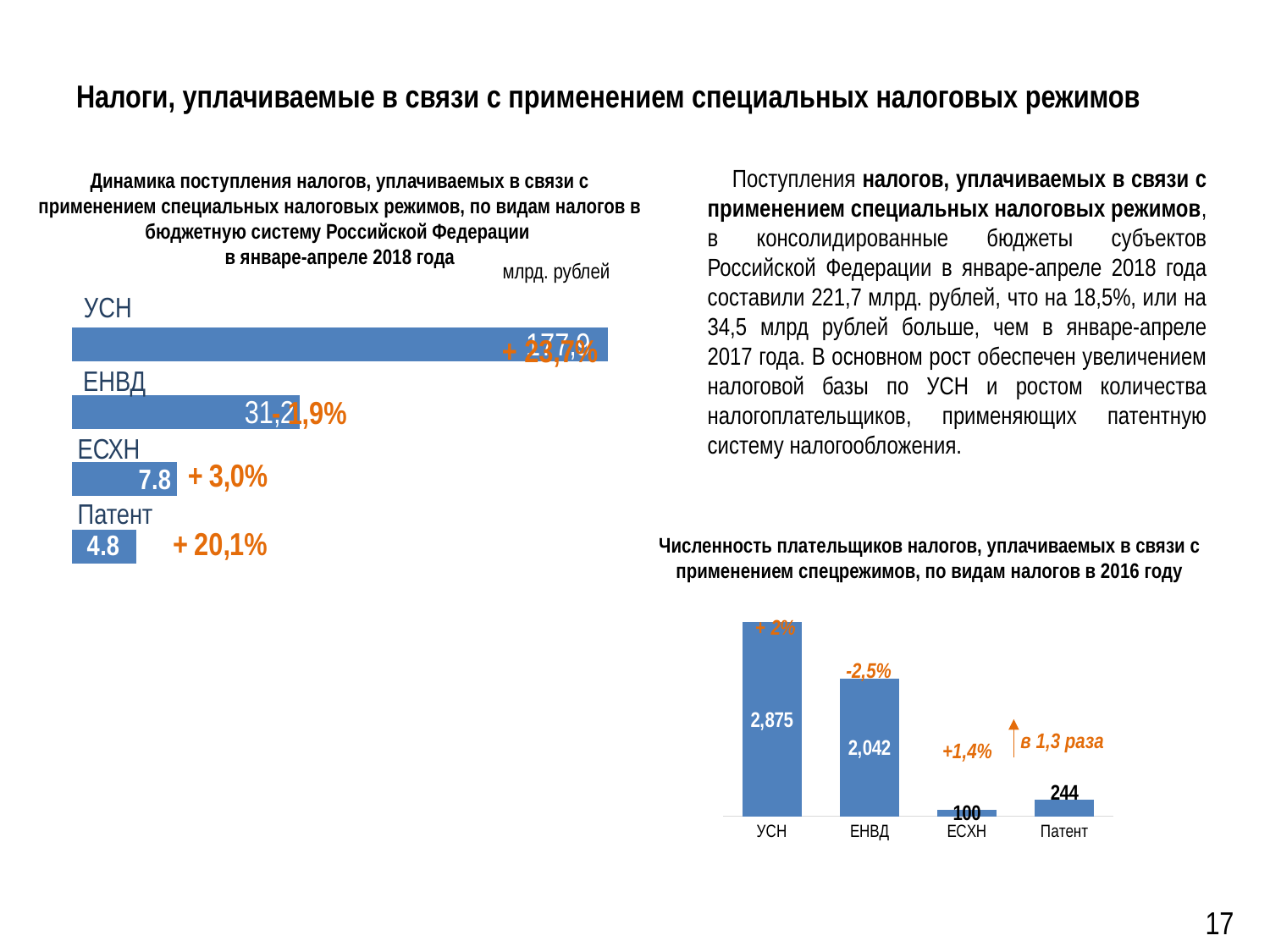
In the chart 'Динамика поступления налогов, уплачиваемых в связи с применением специальных налоговых режимов', what unit is indicated for the values? млрд. рублей In the chart 'Численность плательщиков налогов, уплачиваемых в связи с применением спецрежимов, по видам налогов в 2016 году', which is larger: Патент or ЕСХН? Патент What kind of chart is 'Численность плательщиков налогов, уплачиваемых в связи с применением спецрежимов, по видам налогов в 2016 году'? Bar chart In the chart 'Численность плательщиков налогов, уплачиваемых в связи с применением спецрежимов, по видам налогов в 2016 году', which category has the lowest value? ЕСХН In the chart 'Динамика поступления налогов, уплачиваемых в связи с применением специальных налоговых режимов', what is the difference between the values for ЕСХН and Патент? 3.0 In the chart 'Динамика поступления налогов, уплачиваемых в связи с применением специальных налоговых режимов', what is the value for Патент? 4.8 In the chart 'Динамика поступления налогов, уплачиваемых в связи с применением специальных налоговых режимов', what percentage change is shown next to Патент? + 20,1% In the chart 'Динамика поступления налогов, уплачиваемых в связи с применением специальных налоговых режимов', which category has the shortest bar? Патент In the chart 'Численность плательщиков налогов, уплачиваемых в связи с применением спецрежимов, по видам налогов в 2016 году', what is the value for УСН? 2,875 In the chart 'Динамика поступления налогов, уплачиваемых в связи с применением специальных налоговых режимов', what is the value for ЕСХН? 7.8 In the chart 'Численность плательщиков налогов, уплачиваемых в связи с применением спецрежимов, по видам налогов в 2016 году', what is the value for ЕНВД? 2,042 In the chart 'Динамика поступления налогов, уплачиваемых в связи с применением специальных налоговых режимов', which category has the longest bar? УСН